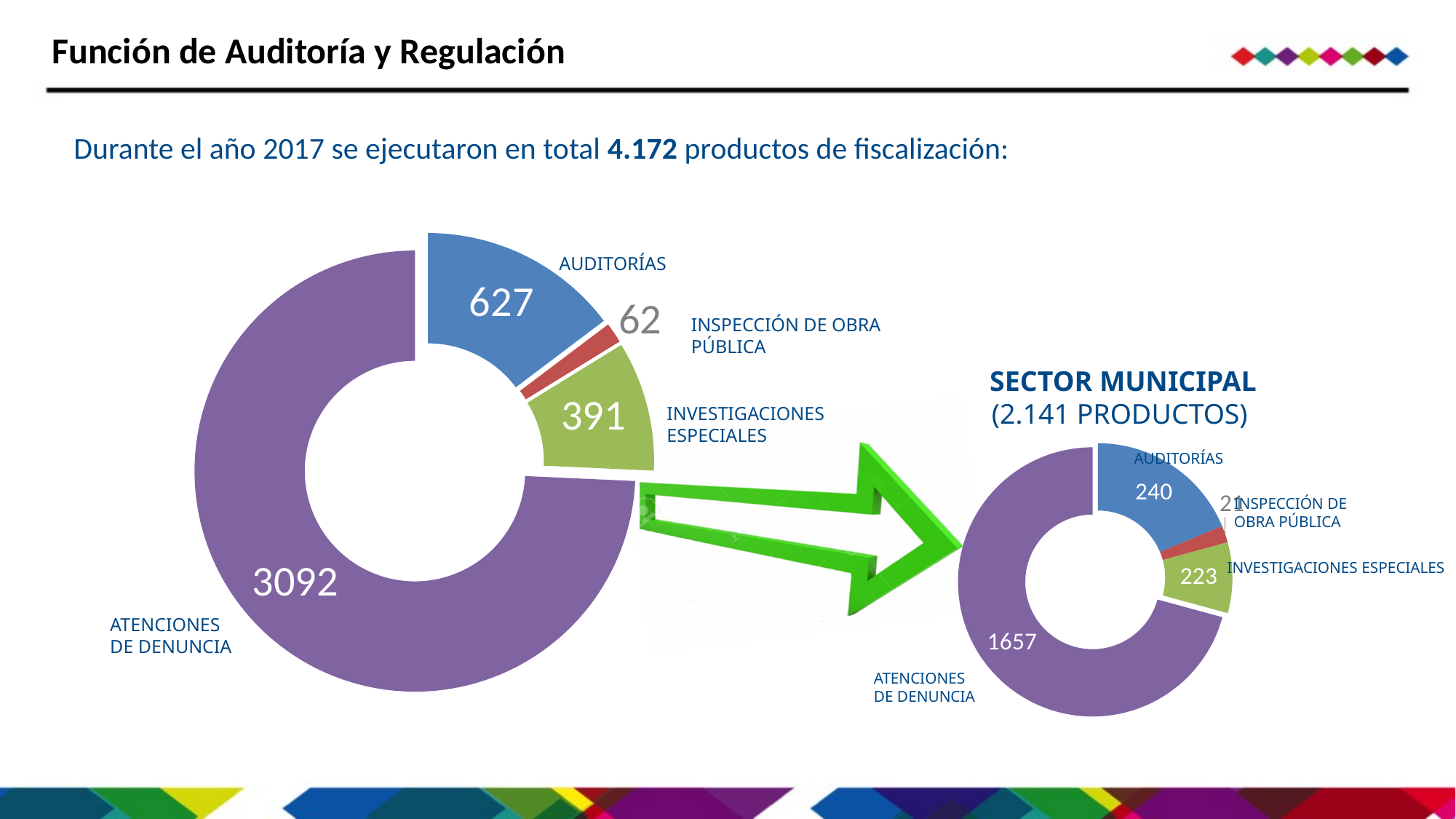
On the left donut chart, what is the value for AUDITORÍAS? 627 How many categories does the left donut chart show? 4 What kind of chart is used on the right side of the slide? Donut chart On the left donut chart, which category has the smallest value? INSPECCIÓN DE OBRA PÚBLICA On the SECTOR MUNICIPAL chart, what is the value for INVESTIGACIONES ESPECIALES? 223 On the left donut chart, what is the value for ATENCIONES DE DENUNCIA? 3092 On the SECTOR MUNICIPAL chart, which is larger, AUDITORÍAS or INVESTIGACIONES ESPECIALES? AUDITORÍAS What is the title of the chart on the right side of the slide? SECTOR MUNICIPAL (2.141 PRODUCTOS) On the left donut chart, what is the value for INSPECCIÓN DE OBRA PÚBLICA? 62 On the SECTOR MUNICIPAL chart, what is the value for ATENCIONES DE DENUNCIA? 1657 On the left donut chart, what is the difference between AUDITORÍAS and INVESTIGACIONES ESPECIALES? 236 On the SECTOR MUNICIPAL chart, which category has the largest value? ATENCIONES DE DENUNCIA